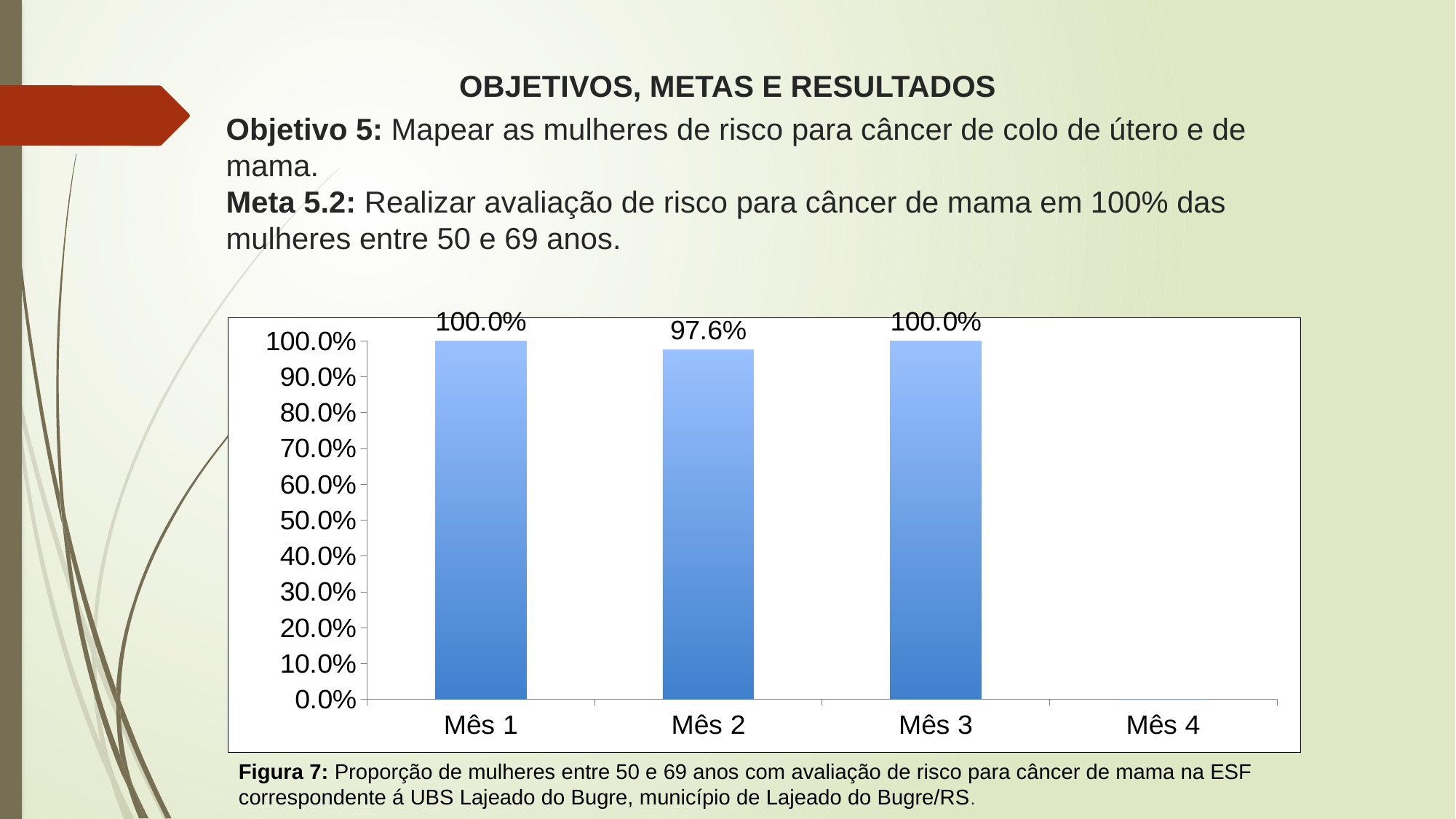
What is the value for Mês 1? 100.0% Is the value for Mês 2 greater or less than 90.0%? greater What figure number is given in the caption below the chart? Figura 7 Which months show a value of 100.0%? Mês 1 and Mês 3 What is the value for Mês 3? 100.0% How many months are shown on the x axis? 4 From Mês 1 to Mês 2, does the value rise or fall? fall What is the difference between the values for Mês 1 and Mês 2? 2.4% Which is larger, the value for Mês 2 or the value for Mês 3? Mês 3 What kind of chart is shown on the slide? bar chart From Mês 2 to Mês 3, does the value rise or fall? rise What is the value for Mês 2? 97.6%